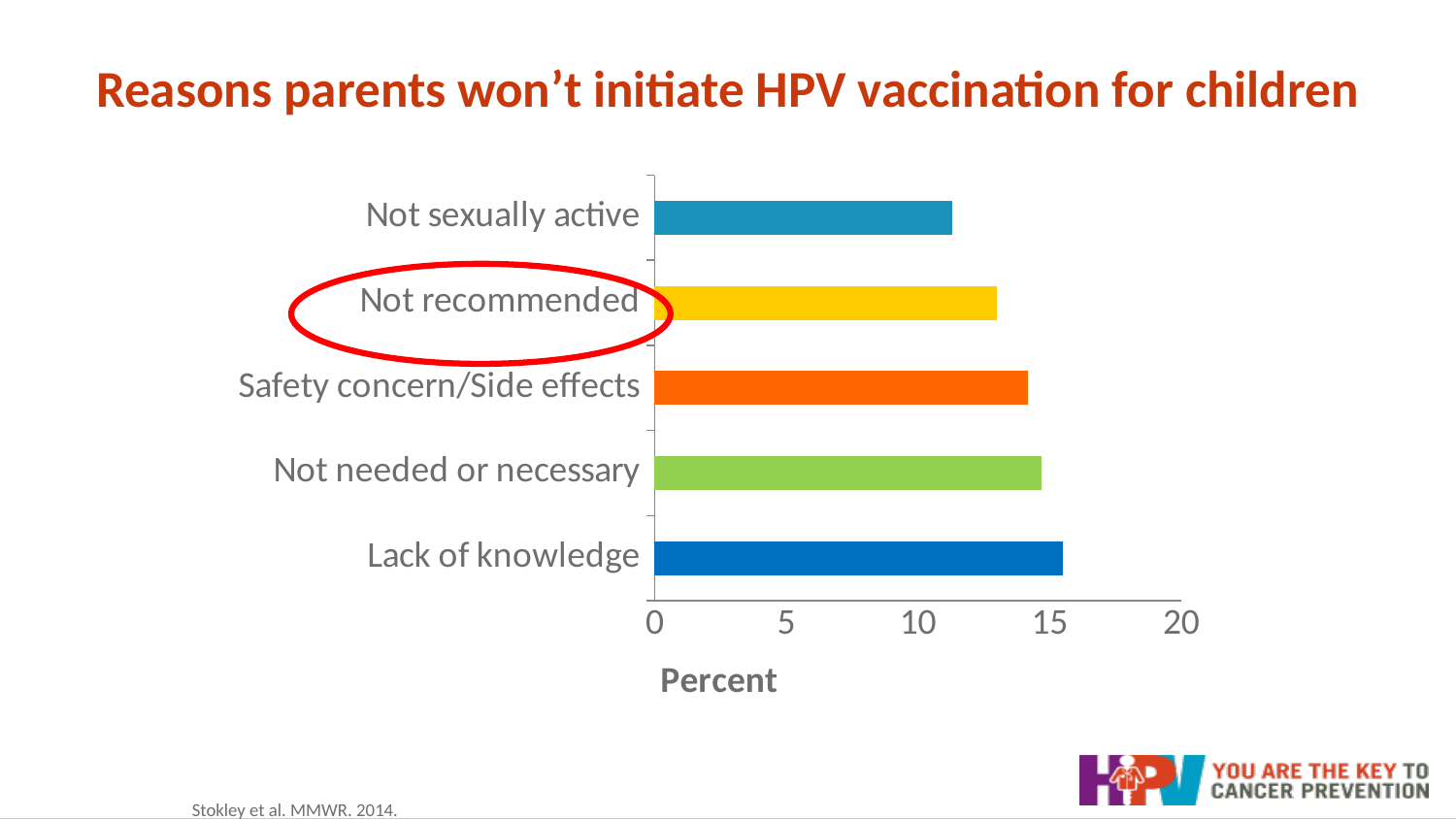
Which is larger, the value for Not recommended or the value for Not sexually active? Not recommended Which category label is circled in red on the chart? Not recommended Is the value for Not recommended greater or less than 10? greater What is the label on the horizontal axis of the chart? Percent Which is larger, the value for Safety concern/Side effects or the value for Not recommended? Safety concern/Side effects Which reason has the highest percentage in the chart? Lack of knowledge Which reason has the lowest percentage in the chart? Not sexually active Is the value for Safety concern/Side effects greater or less than 15? less Is the value for Lack of knowledge greater or less than 10? greater How many reasons (categories) are plotted in the chart? 5 What kind of chart is shown on the slide? bar chart